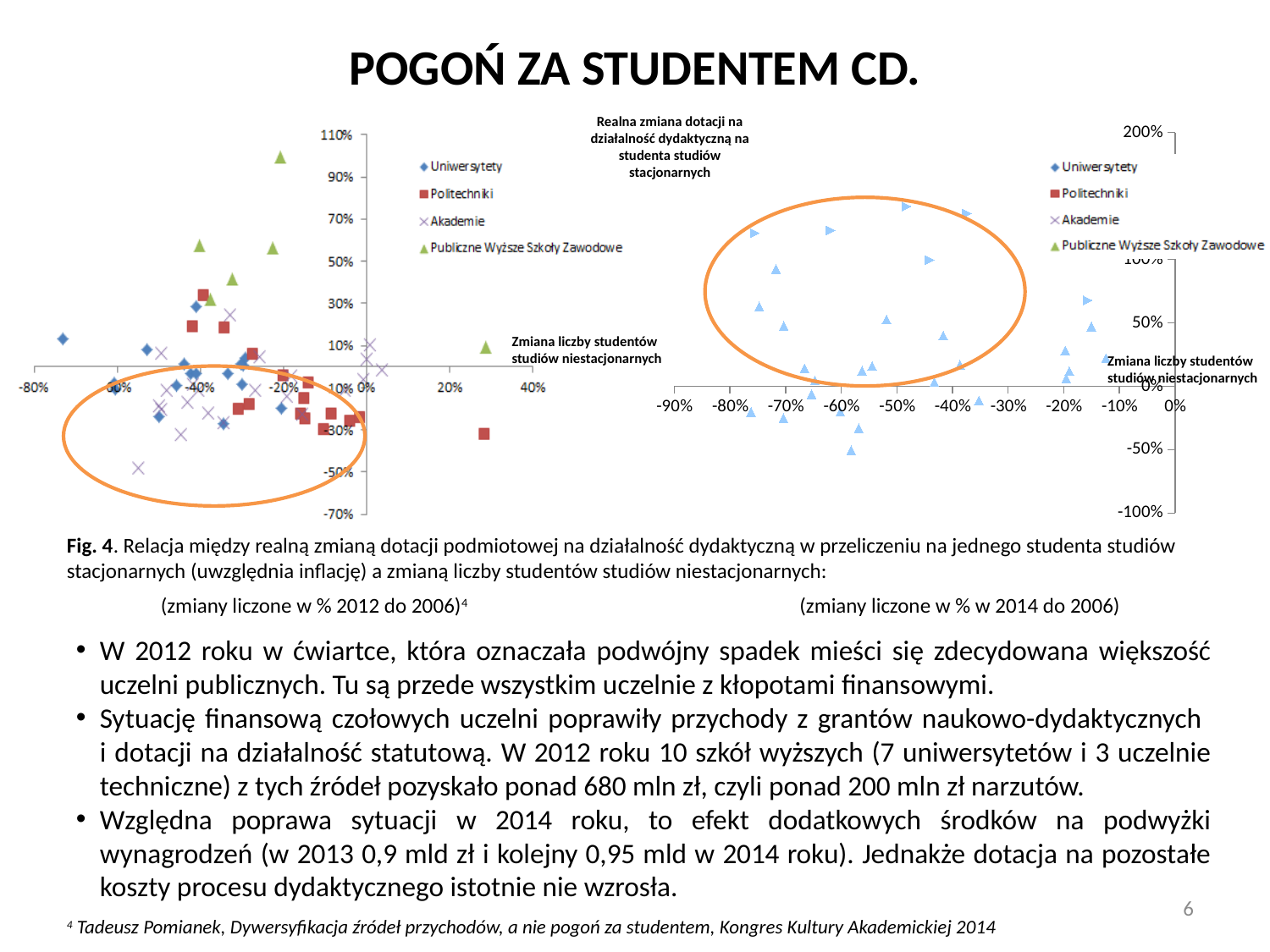
How many series does the legend of the left chart list? 4 In the left chart, which series contains the point with the highest value on the vertical axis? Publiczne Wyższe Szkoły Zawodowe In the left chart, which series is plotted with green triangles? Publiczne Wyższe Szkoły Zawodowe In the left chart, is the highest plotted point greater or less than 90% on the vertical axis? greater What kind of chart is the right chart (zmiany liczone w % w 2014 do 2006)? scatter chart What kind of chart is the left chart (zmiany liczone w % 2012 do 2006)? scatter chart In the right chart, is the highest plotted point greater or less than 100% on the vertical axis? greater How many series does the legend of the right chart list? 4 In the left chart, which series is plotted with red squares? Politechniki In the right chart, is the lowest plotted point greater or less than 0% on the vertical axis? less What is the maximum value shown on the vertical axis of the right chart? 200% In the left chart, which series contains the point with the lowest value on the vertical axis? Akademie